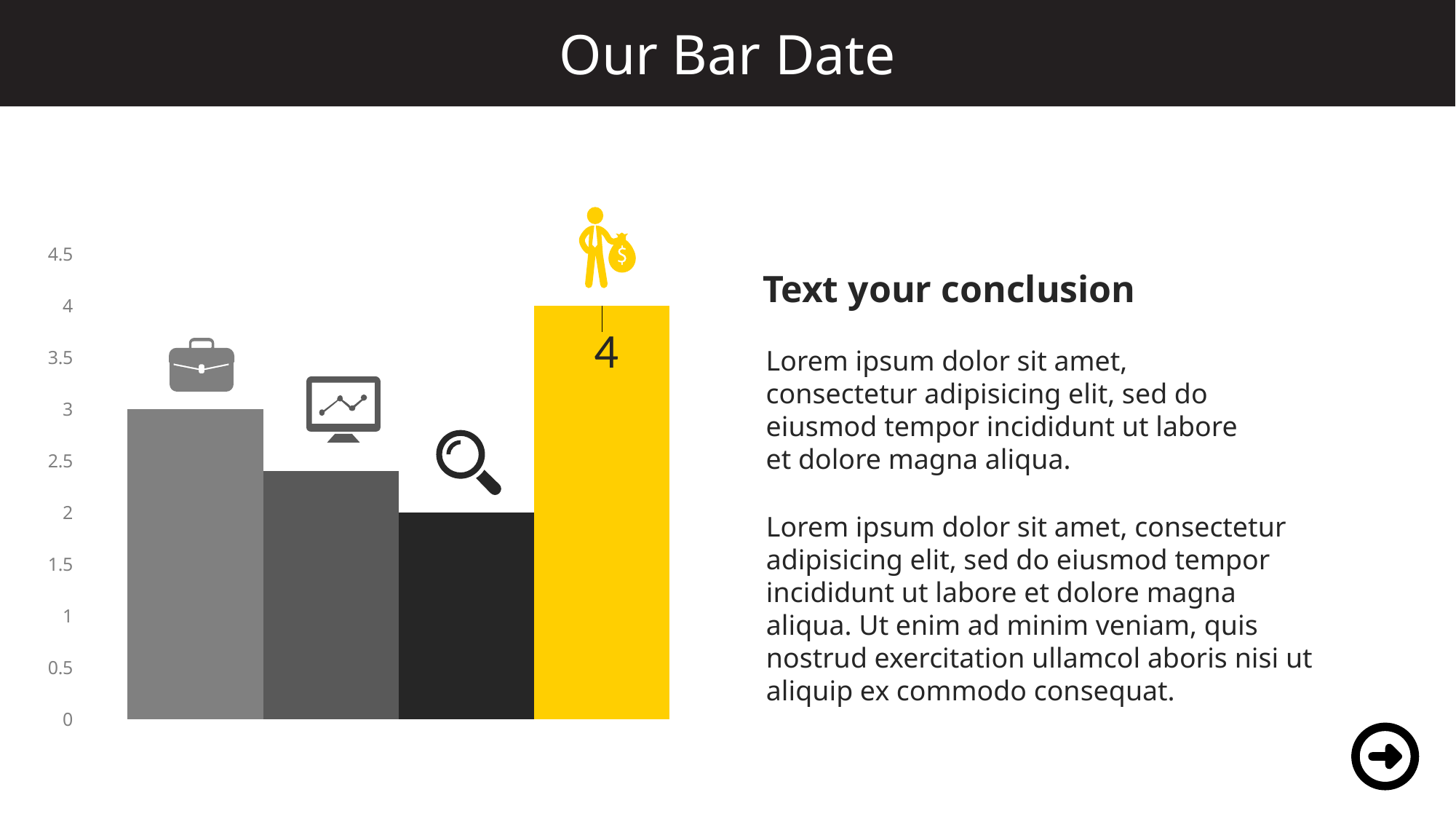
Which bar is the shortest? the third (dark) bar How many bars does the chart contain? 4 What kind of chart is shown on the slide? bar chart What value is labelled on the yellow (fourth) bar? 4 What is the title of the slide containing the chart? Our Bar Date What is the difference between the fourth bar's value and the first bar's value? 1 Which bar is the tallest? the fourth (yellow) bar Which is larger, the first bar or the second bar? the first bar Is the value of the second bar greater or less than 3? less What value does the third bar (with the magnifying glass icon) reach on the axis? 2 Is the value of the second bar greater or less than 2? greater What value does the first (leftmost) bar reach on the axis? 3